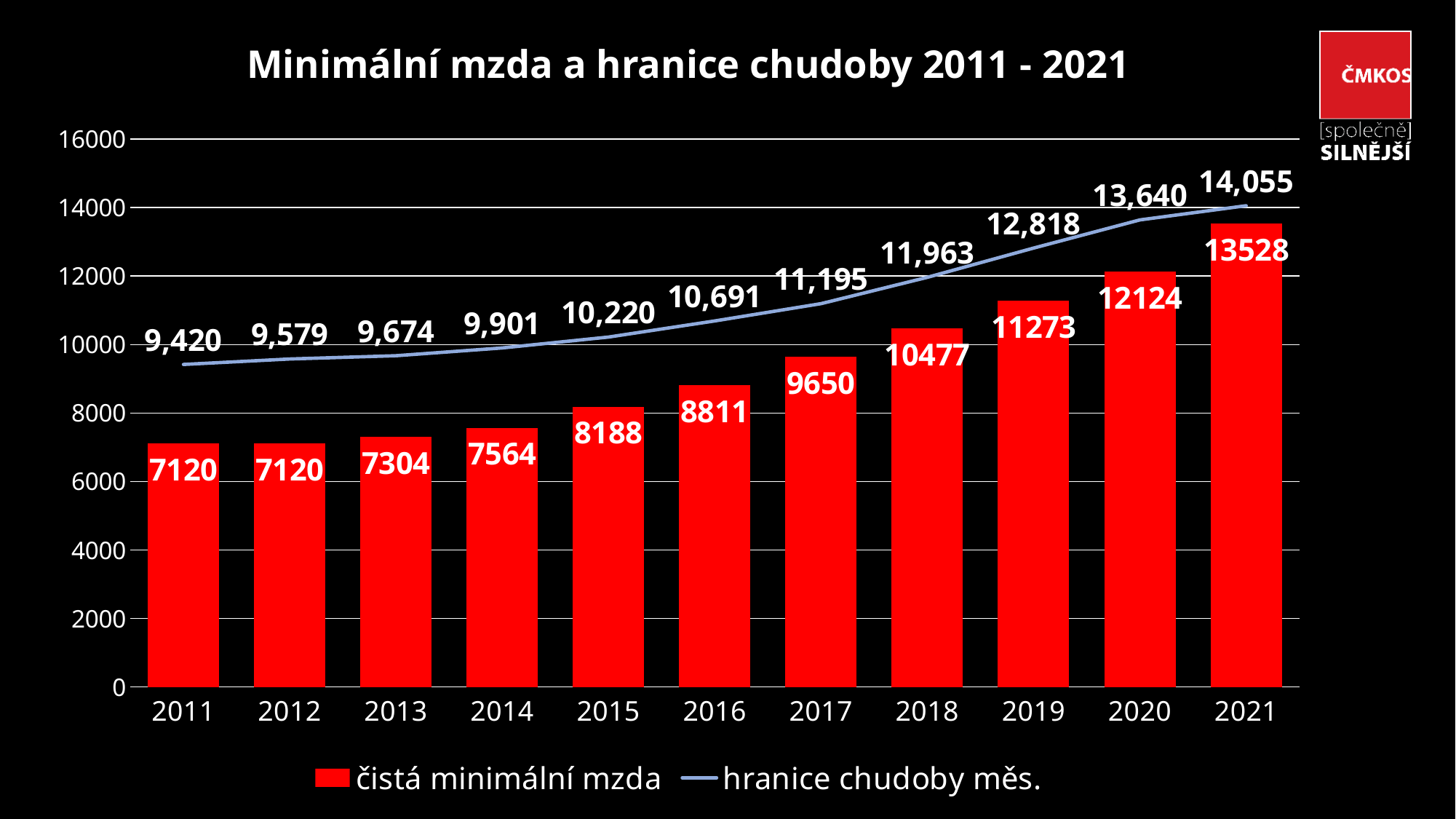
Does čistá minimální mzda rise or fall from 2011 to 2021? Rise What is the value of hranice chudoby měs. in 2014? 9,901 In which year is hranice chudoby měs. lowest? 2011 Which is larger in 2019: čistá minimální mzda or hranice chudoby měs.? hranice chudoby měs. What is the value of hranice chudoby měs. in 2011? 9,420 What is the value of čistá minimální mzda in 2021? 13528 How many years are shown on the x axis? 11 How many series does the legend list? 2 What is the difference between hranice chudoby měs. and čistá minimální mzda in 2021? 527 What kind of chart is this? Combined bar and line chart In which year is čistá minimální mzda highest? 2021 What is the value of čistá minimální mzda in 2017? 9650